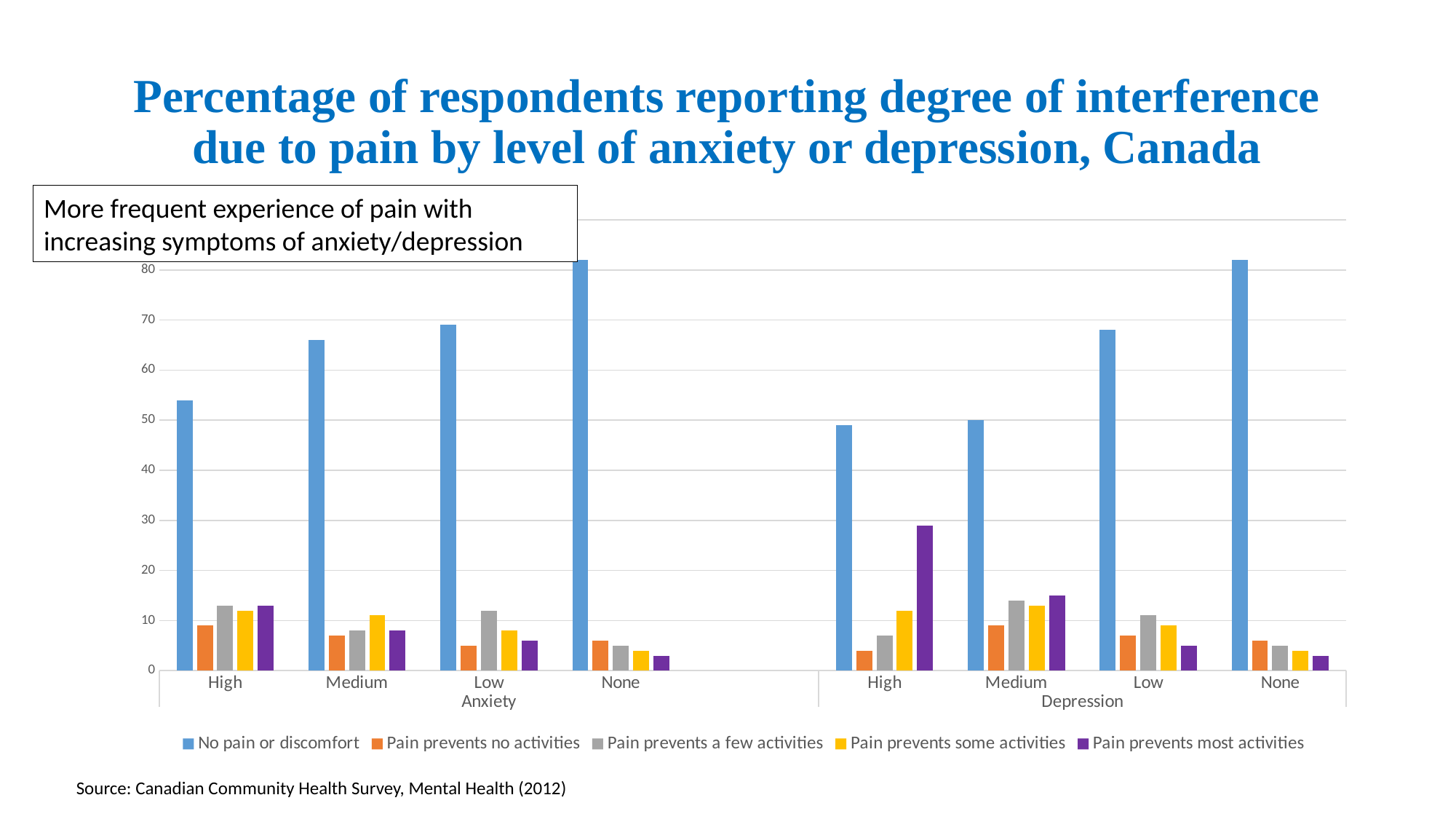
What is the source cited below the chart? Canadian Community Health Survey, Mental Health (2012) How many category groups are shown along the x axis? 8 Does the 'No pain or discomfort' value rise or fall as anxiety level goes from High to None? rise How many series does the legend list? 5 Which anxiety level has the highest value for 'No pain or discomfort'? None Is the value for 'No pain or discomfort' at Anxiety High greater or less than 50? greater Is the value for 'No pain or discomfort' at Anxiety None greater or less than 80? greater Is the value for 'Pain prevents most activities' at Depression High greater or less than 20? greater What kind of chart is shown on the slide? bar chart Which is larger: 'Pain prevents most activities' at Depression High or at Anxiety High? Depression High